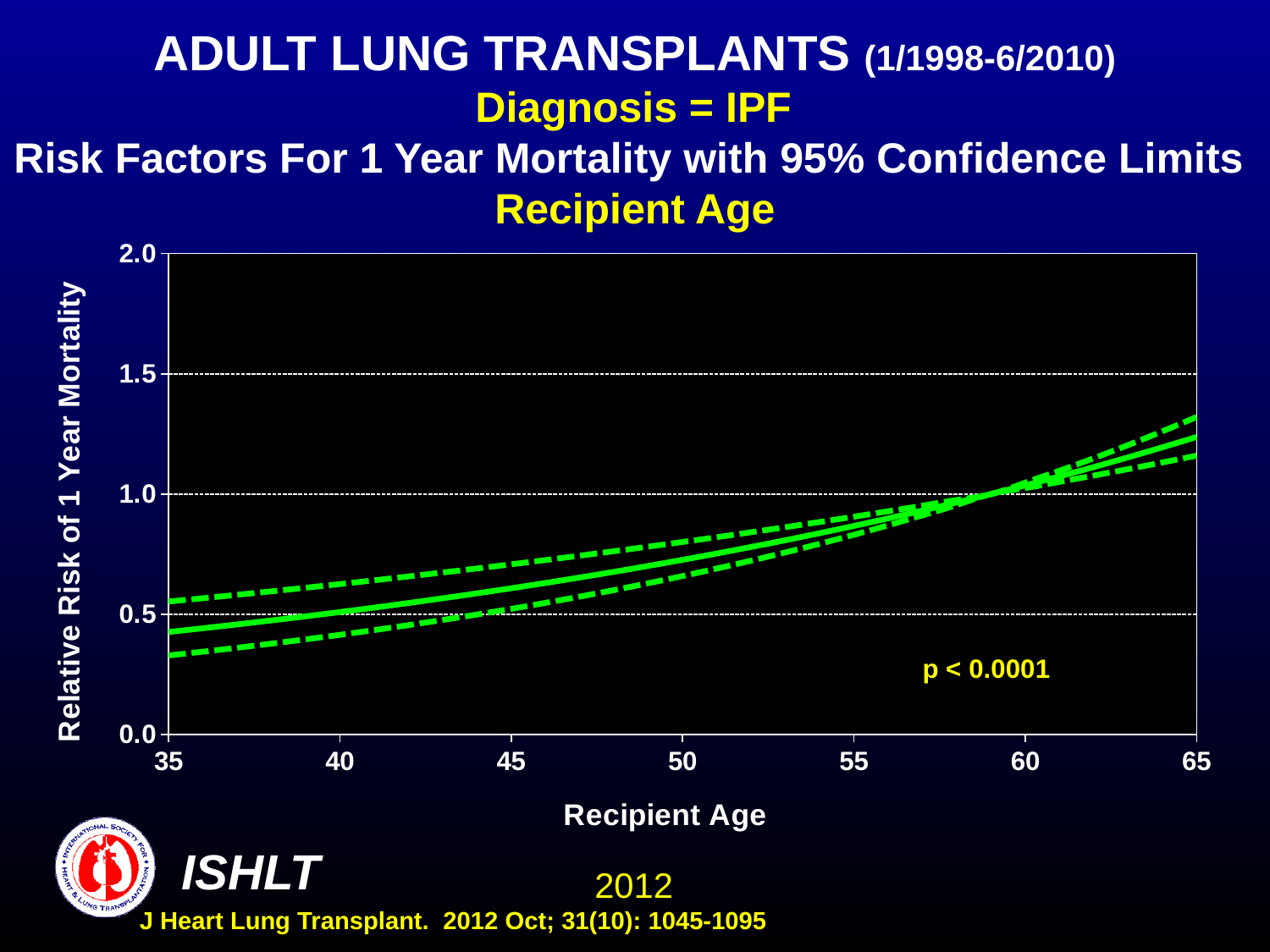
Is the relative risk on the solid line at recipient age 35 greater or less than 0.5? less What p-value is printed on the chart? p < 0.0001 Is the lower dashed confidence limit at recipient age 35 greater or less than 0.5? less Does the relative risk of 1 year mortality rise or fall as recipient age increases from 35 to 65? rise Is the relative risk on the solid line at recipient age 50 greater or less than 0.5? greater What is the label of the y axis? Relative Risk of 1 Year Mortality What kind of chart is shown on the slide? line chart Which has the larger relative risk on the solid line: recipient age 35 or recipient age 65? recipient age 65 How many lines are plotted on the chart? 3